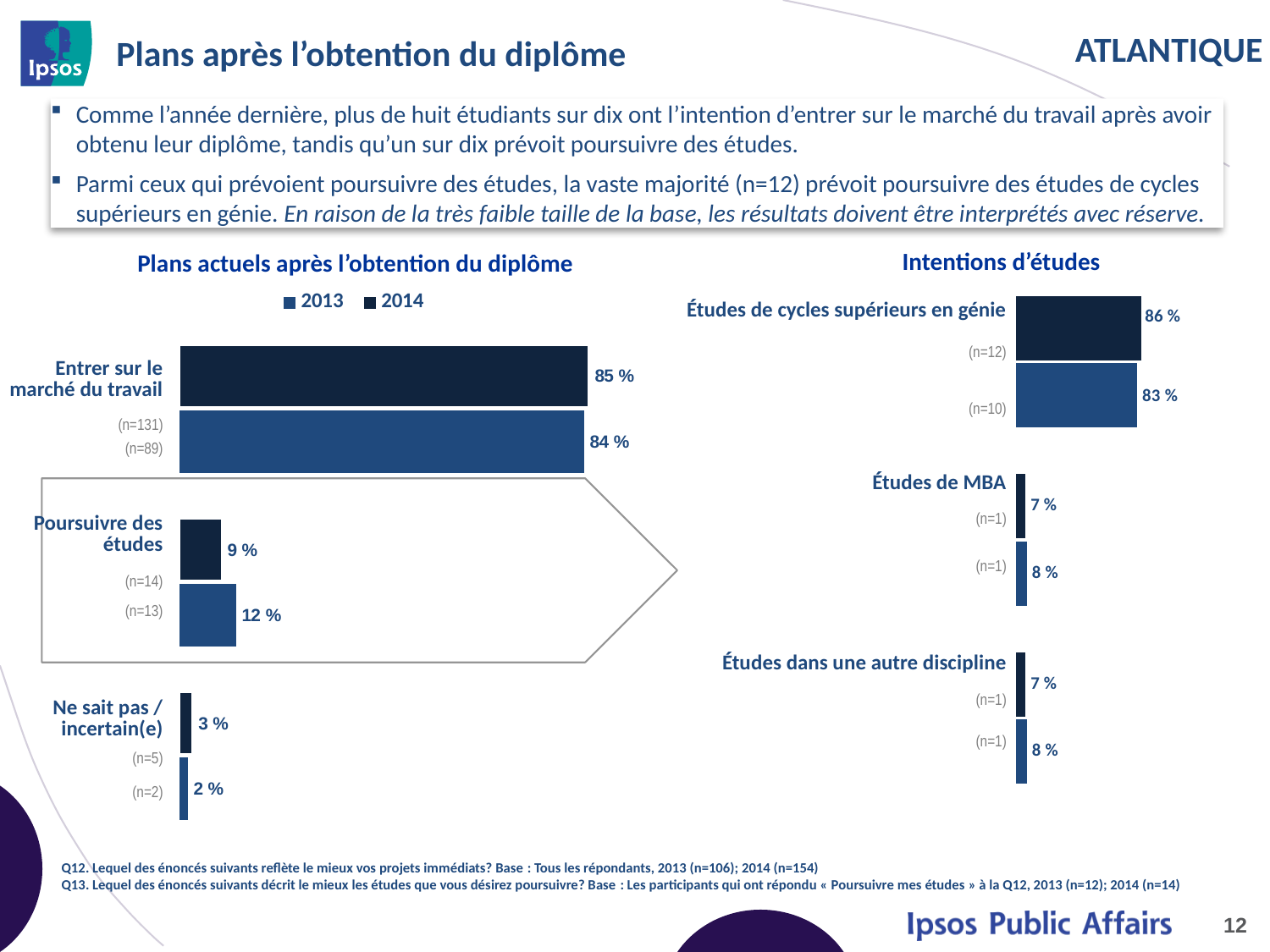
In the chart 'Intentions d'études', what is the value of the upper (dark) bar for 'Études de cycles supérieurs en génie'? 86 % In the chart 'Plans actuels après l'obtention du diplôme', what is the 2014 value for 'Ne sait pas / incertain(e)'? 2 % In the chart 'Plans actuels après l'obtention du diplôme', which category has the lowest 2014 value? Ne sait pas / incertain(e) In the chart 'Plans actuels après l'obtention du diplôme', what is the 2014 value for 'Entrer sur le marché du travail'? 84 % In the chart 'Plans actuels après l'obtention du diplôme', how many series does the legend list? 2 In the chart 'Plans actuels après l'obtention du diplôme', what is the 2013 value for 'Poursuivre des études'? 9 % In the chart 'Intentions d'études', which category has the highest values? Études de cycles supérieurs en génie In the chart 'Plans actuels après l'obtention du diplôme', how many categories are shown? 3 What kind of chart is 'Intentions d'études'? Bar chart In the chart 'Plans actuels après l'obtention du diplôme', which category has the highest 2013 value? Entrer sur le marché du travail In the chart 'Plans actuels après l'obtention du diplôme', what is the difference between the 2014 and 2013 values for 'Poursuivre des études'? 3 % In the chart 'Intentions d'études', what is the value of the lower bar for 'Études de MBA'? 8 %